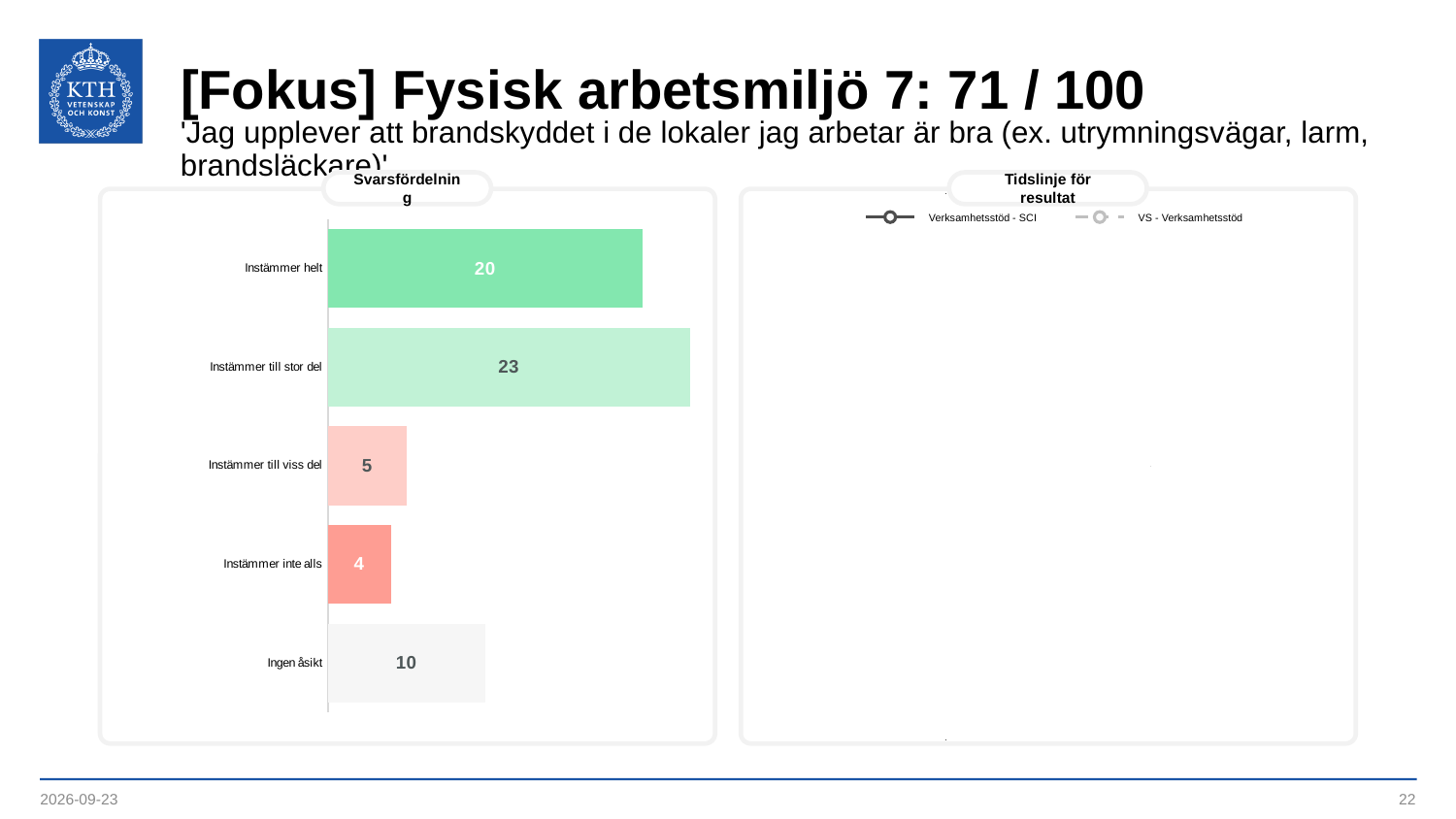
What kind of chart is the Svarsfördelning chart? bar chart In the Svarsfördelning chart, what is the value for Instämmer till viss del? 5 In the Svarsfördelning chart, what is the difference between Instämmer till stor del and Instämmer helt? 3 In the Svarsfördelning chart, what is the total of Instämmer helt and Instämmer till stor del? 43 In the Svarsfördelning chart, which category has the lowest value? Instämmer inte alls How many series does the legend of the Tidslinje för resultat chart list? 2 In the Svarsfördelning chart, what is the value for Ingen åsikt? 10 How many categories does the Svarsfördelning chart show? 5 In the Svarsfördelning chart, which category has the highest value? Instämmer till stor del In the Svarsfördelning chart, what is the value for Instämmer till stor del? 23 In the Svarsfördelning chart, which is larger: Ingen åsikt or Instämmer till viss del? Ingen åsikt In the Svarsfördelning chart, what is the value for Instämmer helt? 20